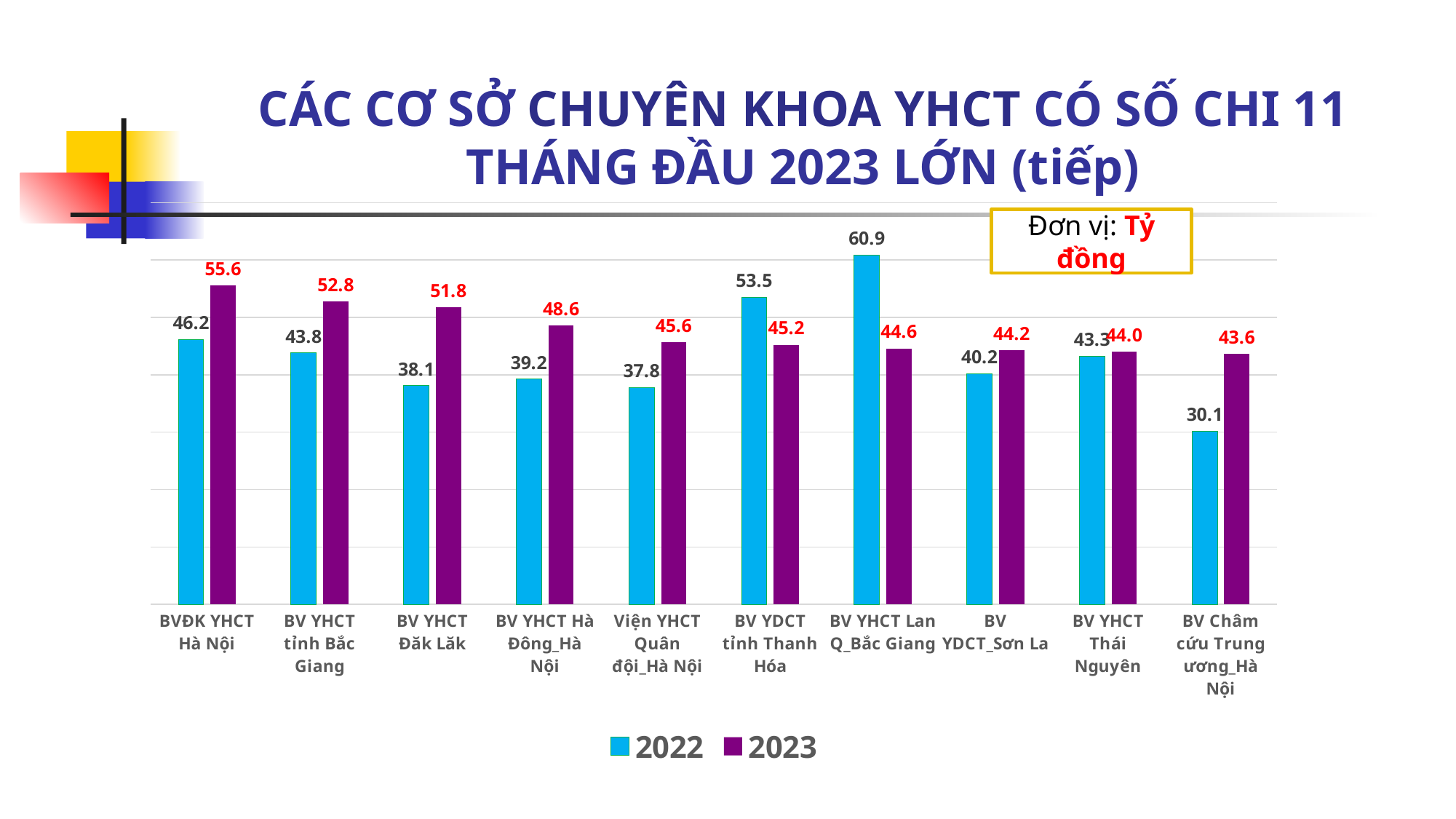
What kind of chart is shown on the slide? Bar chart Which facility has the highest 2022 value? BV YHCT Lan Q_Bắc Giang Which facility has the lowest 2023 value? BV Châm cứu Trung ương_Hà Nội How many series does the legend list? 2 What is the 2022 value for BV YHCT Lan Q_Bắc Giang? 60.9 For BV YDCT tỉnh Thanh Hóa, which year has the larger value, 2022 or 2023? 2022 Which facility has the lowest 2022 value? BV Châm cứu Trung ương_Hà Nội What is the 2023 value for BVĐK YHCT Hà Nội? 55.6 What is the difference between the 2023 and 2022 values for BV YHCT Đăk Lăk? 13.7 What unit is stated in the box on the chart? Tỷ đồng How many facilities are shown on the x axis? 10 What is the 2022 value for BV Châm cứu Trung ương_Hà Nội? 30.1